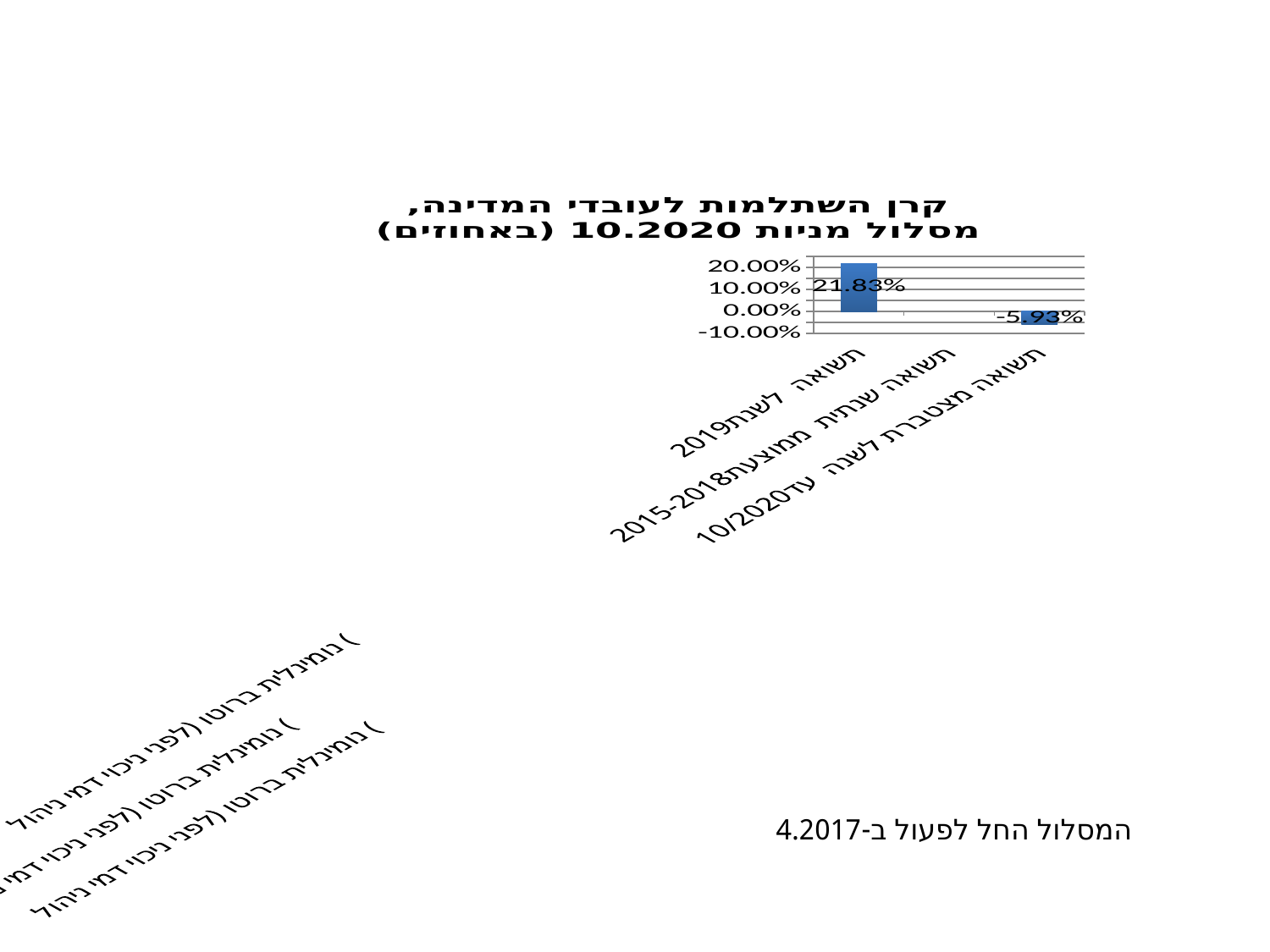
What kind of chart is shown on the slide? bar chart Is the value for תשואה לשנת 2019 greater or less than 10.00%? greater What is the difference between the value for תשואה לשנת 2019 and the value for תשואה מצטברת לשנה עד 10/2020? 27.76% Which is larger: the value for תשואה לשנת 2019 or the value for תשואה מצטברת לשנה עד 10/2020? תשואה לשנת 2019 What is the value for תשואה מצטברת לשנה עד 10/2020? -5.93% Which category on the x axis has no visible bar? תשואה שנתית ממוצעת 2015-2018 How many categories are shown on the x axis of the chart? 3 What is the title of the chart? קרן השתלמות לעובדי המדינה, מסלול מניות 10.2020 (באחוזים) What is the value for תשואה לשנת 2019? 21.83% Is the value for תשואה מצטברת לשנה עד 10/2020 greater or less than 0.00%? less Which category with a plotted bar has the lowest value? תשואה מצטברת לשנה עד 10/2020 Which category has the highest value? תשואה לשנת 2019